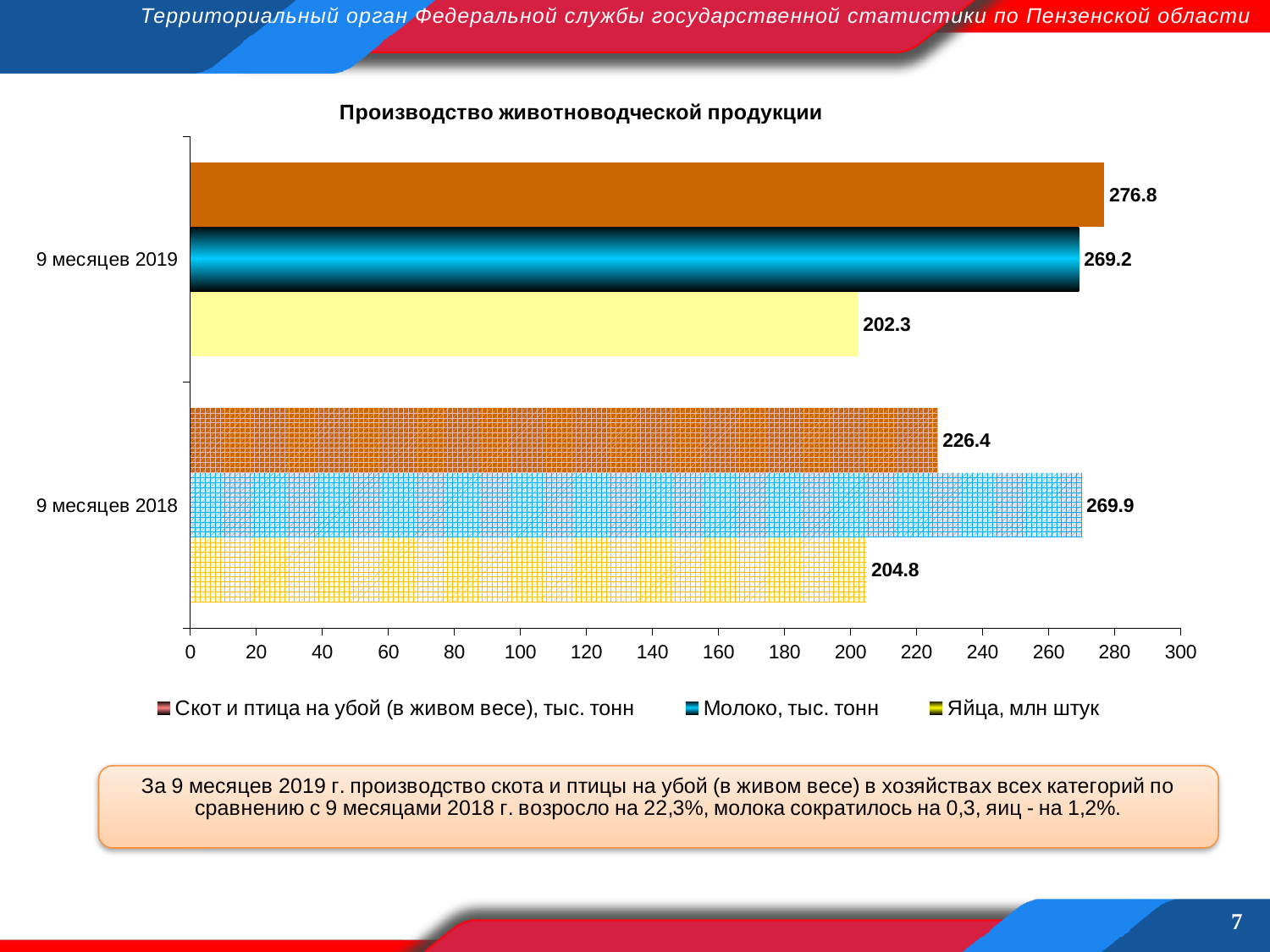
What is the value for Скот и птица на убой (в живом весе), тыс. тонн for 9 месяцев 2018? 226.4 What is the value for Скот и птица на убой (в живом весе), тыс. тонн for 9 месяцев 2019? 276.8 What is the title of the chart? Производство животноводческой продукции What is the difference between the Яйца, млн штук values for 9 месяцев 2018 and 9 месяцев 2019? 2.5 Which is larger: Скот и птица на убой (в живом весе) for 9 месяцев 2019 or for 9 месяцев 2018? 9 месяцев 2019 What is the value for Молоко, тыс. тонн for 9 месяцев 2018? 269.9 What is the difference between the Скот и птица на убой (в живом весе) values for 9 месяцев 2019 and 9 месяцев 2018? 50.4 How many series does the legend list? 3 What is the value for Яйца, млн штук for 9 месяцев 2019? 202.3 What kind of chart is shown on the slide? Bar chart Which series has the lowest value for 9 месяцев 2018? Яйца, млн штук Which series has the highest value for 9 месяцев 2019? Скот и птица на убой (в живом весе), тыс. тонн